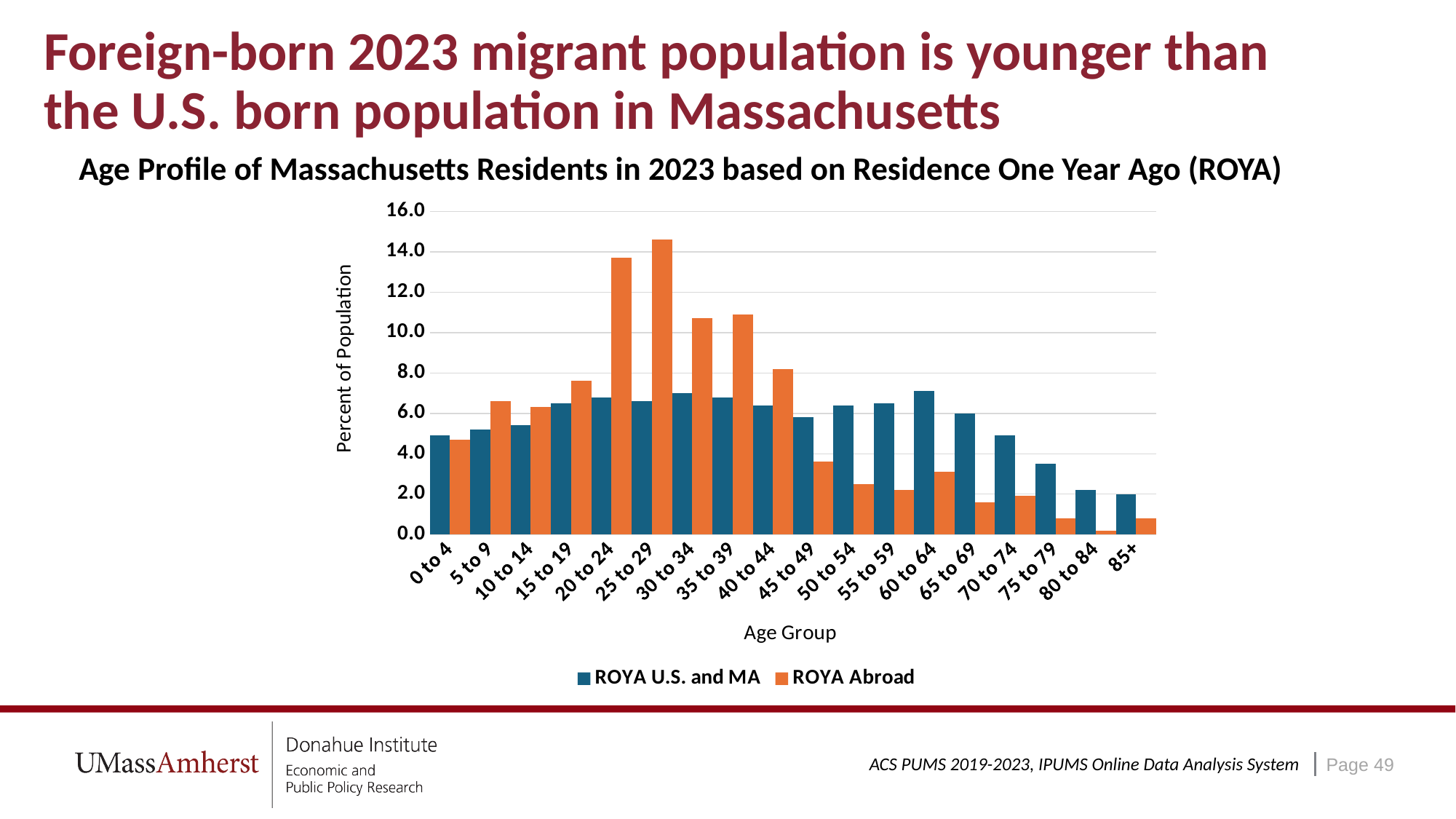
Which age group has the highest value for ROYA Abroad? 25 to 29 How many age group categories are shown on the x axis? 18 Is the ROYA Abroad value for 20 to 24 greater or less than 12.0? greater What kind of chart is shown on the slide? bar chart What is the label of the vertical axis? Percent of Population For the 60 to 64 age group, which series has the larger value, ROYA U.S. and MA or ROYA Abroad? ROYA U.S. and MA Is the ROYA Abroad value for 25 to 29 greater or less than 14.0? greater How many series does the legend list? 2 Is the ROYA Abroad value for 45 to 49 greater or less than 4.0? less Do the ROYA Abroad values generally rise or fall from the 25 to 29 age group to the 85+ age group? fall Which age group has the lowest value for ROYA Abroad? 80 to 84